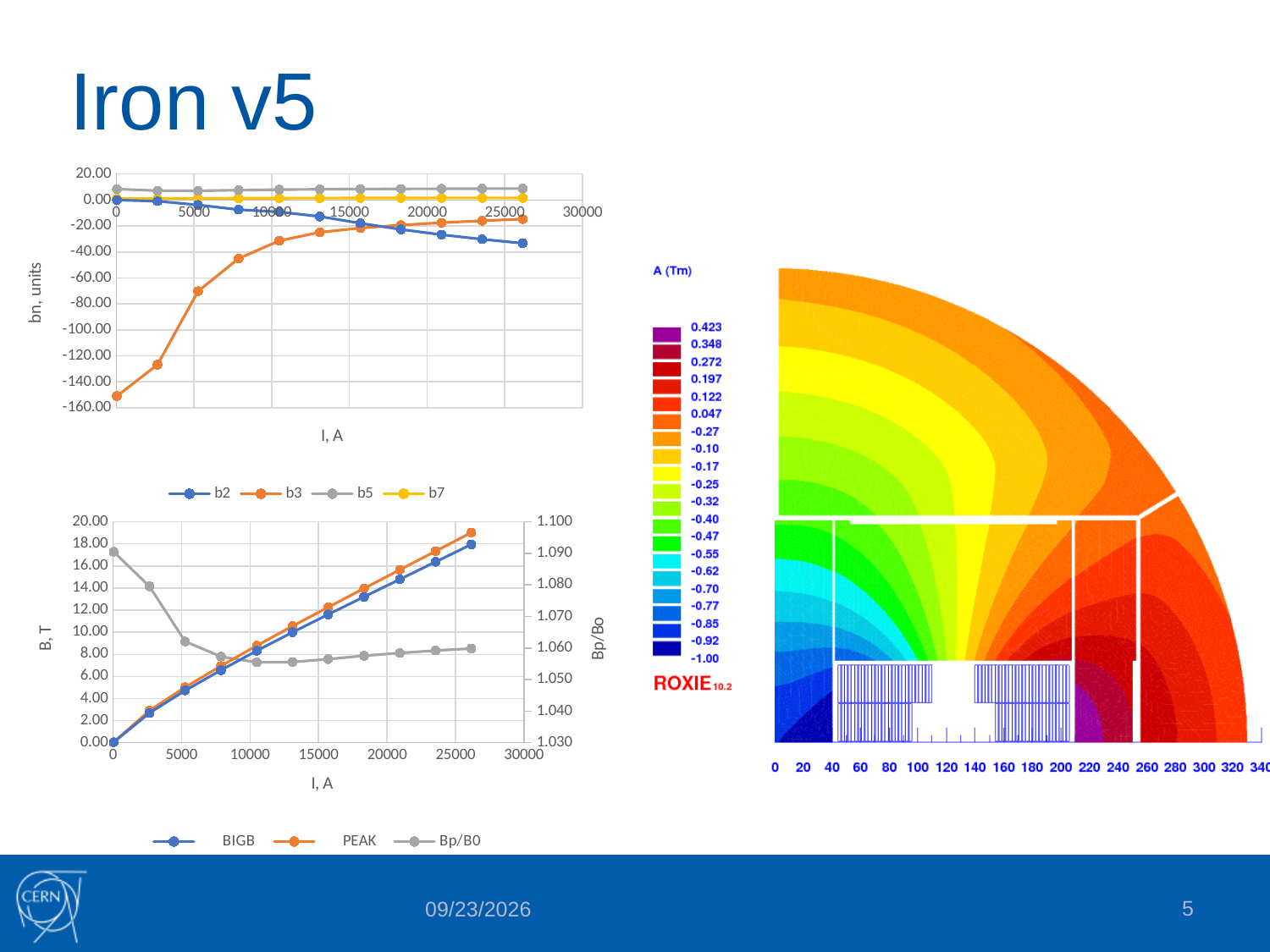
What kind of chart is the top chart (bn, units vs I, A)? line chart In the top chart, does b2 rise or fall as I increases? falls In the top chart, is the value of b3 at I = 0 greater or less than -140.00? less In the top chart, which series has the lowest value at I = 0? b3 In the top chart, does b3 rise or fall as I increases? rises In the bottom chart, which is larger at the highest current shown, BIGB or PEAK? PEAK How many series does the legend of the bottom chart list? 3 What is the label of the right-hand vertical axis of the bottom chart? Bp/Bo In the bottom chart, does PEAK rise or fall as I increases? rises In the bottom chart, is the value of BIGB at the highest current shown greater or less than 16.00? greater How many series does the legend of the top chart list? 4 In the top chart, which series has the highest values across the current range? b5